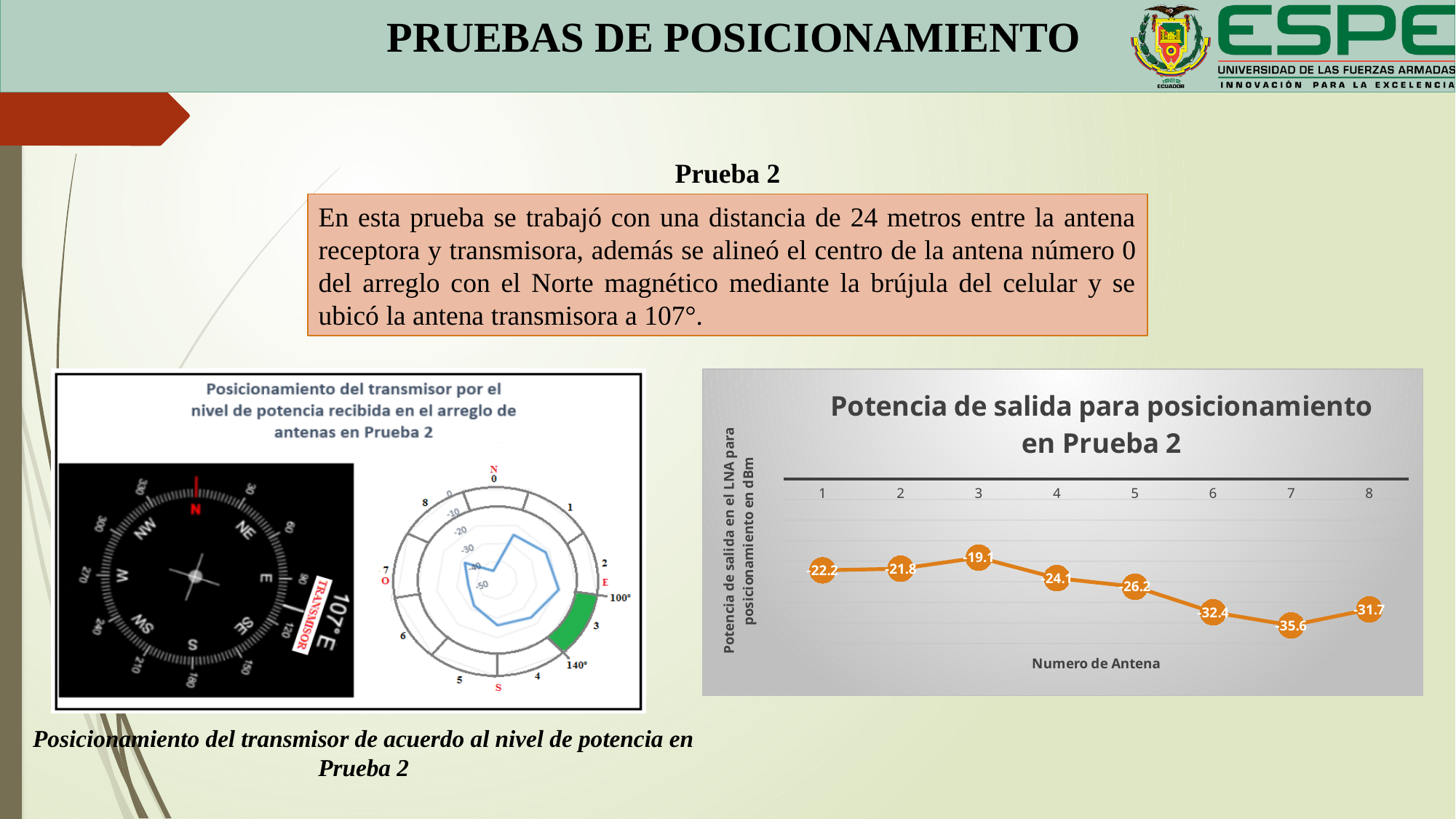
In the chart titled 'Potencia de salida para posicionamiento en Prueba 2', what is the value for antenna number 3? -19.1 In the chart titled 'Potencia de salida para posicionamiento en Prueba 2', what is the value for antenna number 7? -35.6 What kind of chart is the chart titled 'Potencia de salida para posicionamiento en Prueba 2'? line chart In the chart titled 'Potencia de salida para posicionamiento en Prueba 2', do the values rise or fall from antenna 3 to antenna 7? fall What is the x-axis title of the chart titled 'Potencia de salida para posicionamiento en Prueba 2'? Numero de Antena In the chart titled 'Potencia de salida para posicionamiento en Prueba 2', what is the value for antenna number 8? -31.7 In the chart titled 'Potencia de salida para posicionamiento en Prueba 2', which has the larger value, antenna 5 or antenna 6? antenna 5 In the chart titled 'Potencia de salida para posicionamiento en Prueba 2', what is the difference between the values for antenna 3 and antenna 7? 16.5 In the chart titled 'Potencia de salida para posicionamiento en Prueba 2', which antenna number has the lowest output power? 7 In the chart titled 'Potencia de salida para posicionamiento en Prueba 2', which antenna number has the highest output power? 3 In the chart titled 'Potencia de salida para posicionamiento en Prueba 2', what is the value for antenna number 1? -22.2 In the chart titled 'Potencia de salida para posicionamiento en Prueba 2', how many antenna numbers are plotted? 8